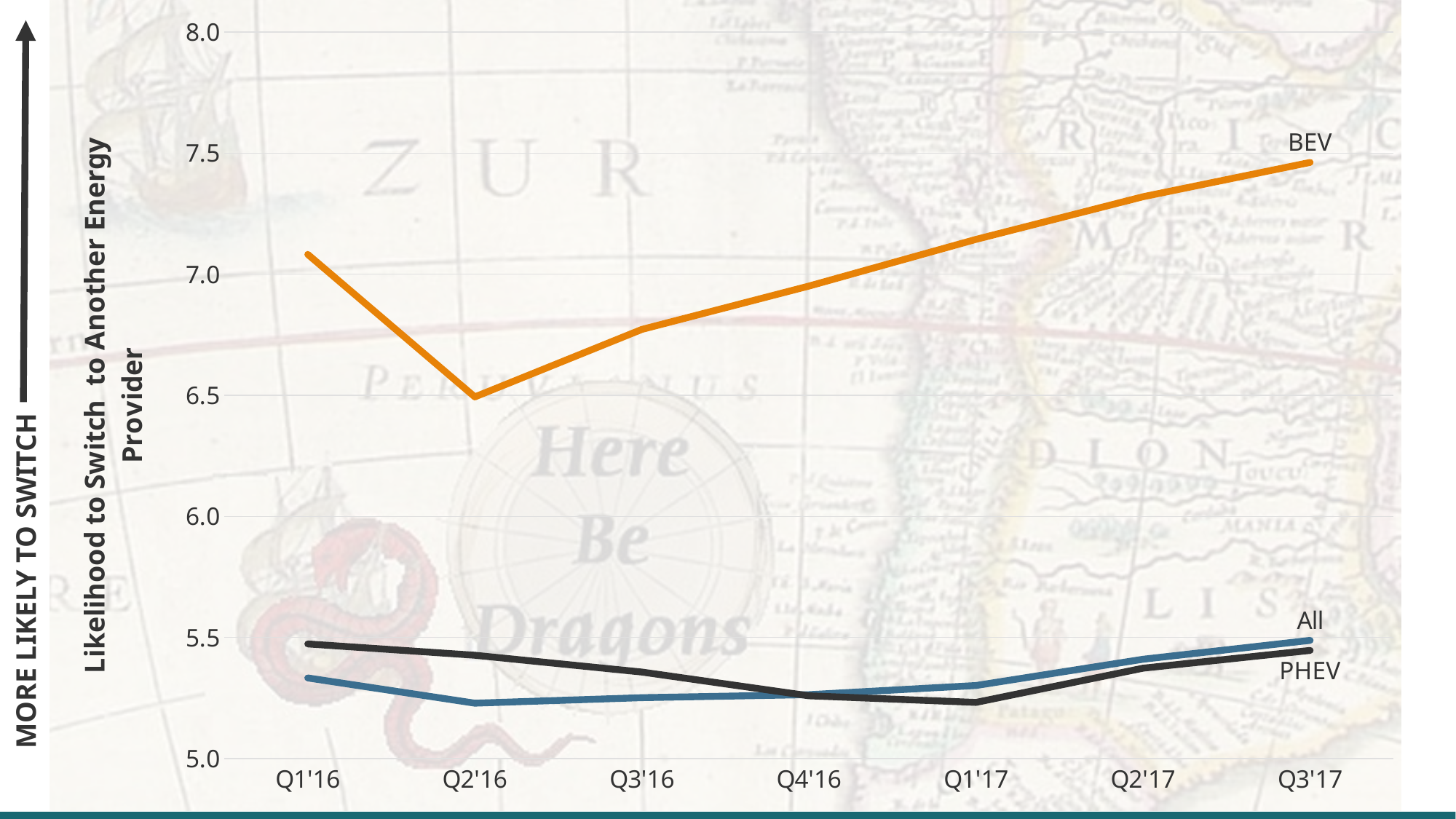
Which series is drawn in orange? BEV How many series are plotted on the chart? 3 What type of chart is shown on the slide? line chart Does the BEV series rise or fall from Q2'16 to Q3'17? rise Is the value for BEV in Q3'16 greater or less than 6.5? greater In which quarter is the BEV series at its highest? Q3'17 Is the value for BEV in Q1'16 greater or less than 7.0? greater Which series has the higher value in Q3'17, BEV or PHEV? BEV In which quarter is the BEV series at its lowest? Q2'16 How many quarters are plotted along the x axis? 7 Is the value for PHEV in Q1'17 greater or less than 5.5? less